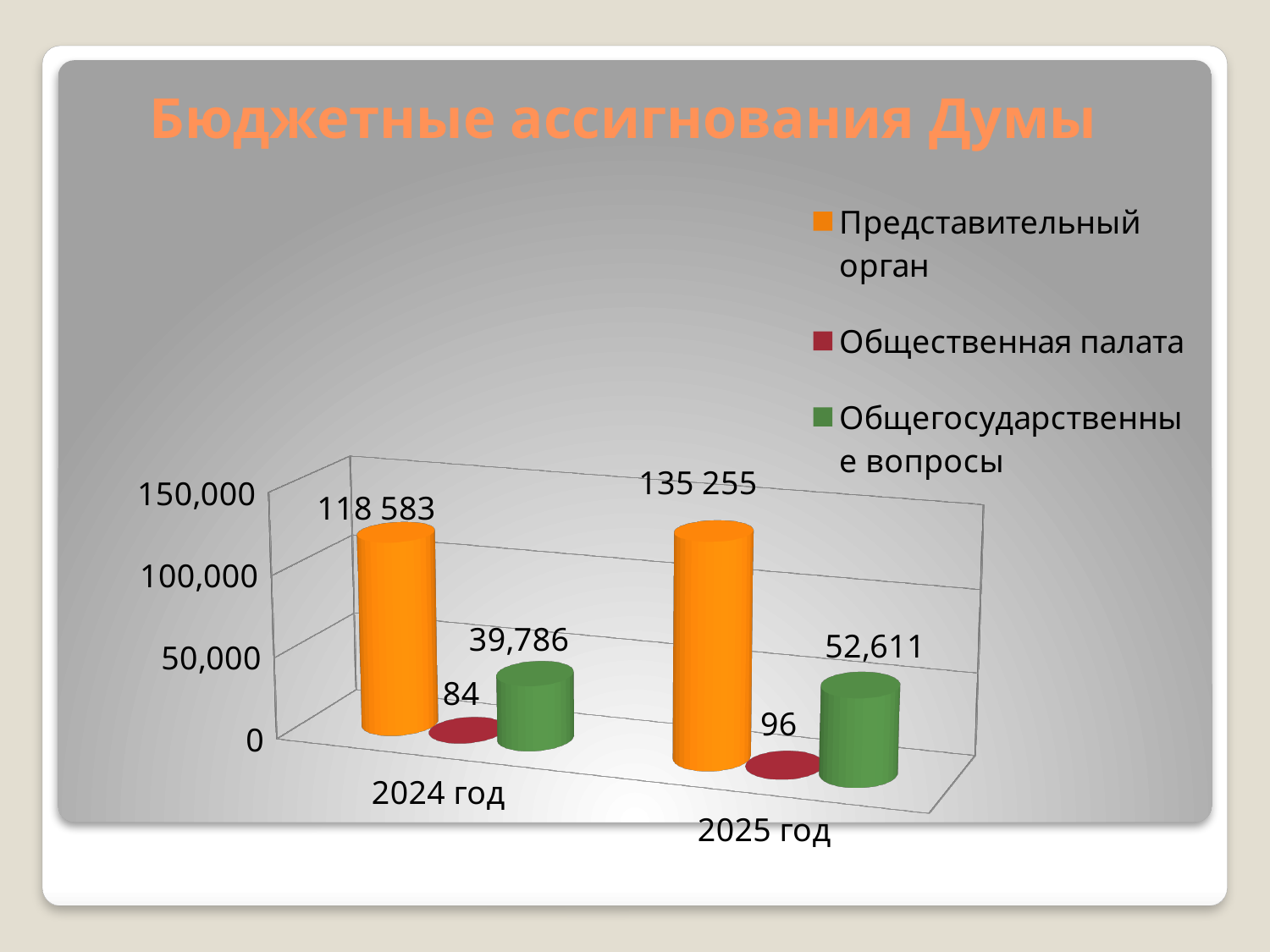
What is the value for Представительный орган in 2025 год? 135 255 What is the value for Представительный орган in 2024 год? 118 583 How many series does the legend list? 3 What is the value for Общегосударственные вопросы in 2025 год? 52,611 Which series has the lowest value in 2024 год? Общественная палата Does the value for Представительный орган rise or fall from 2024 год to 2025 год? rise By how much does the value for Общественная палата change from 2024 год to 2025 год? 12 What is the value for Общегосударственные вопросы in 2024 год? 39,786 What is the title of the chart? Бюджетные ассигнования Думы Which series has the highest value in 2025 год? Представительный орган What is the value for Общественная палата in 2025 год? 96 Which is larger: Общегосударственные вопросы in 2024 год or in 2025 год? 2025 год